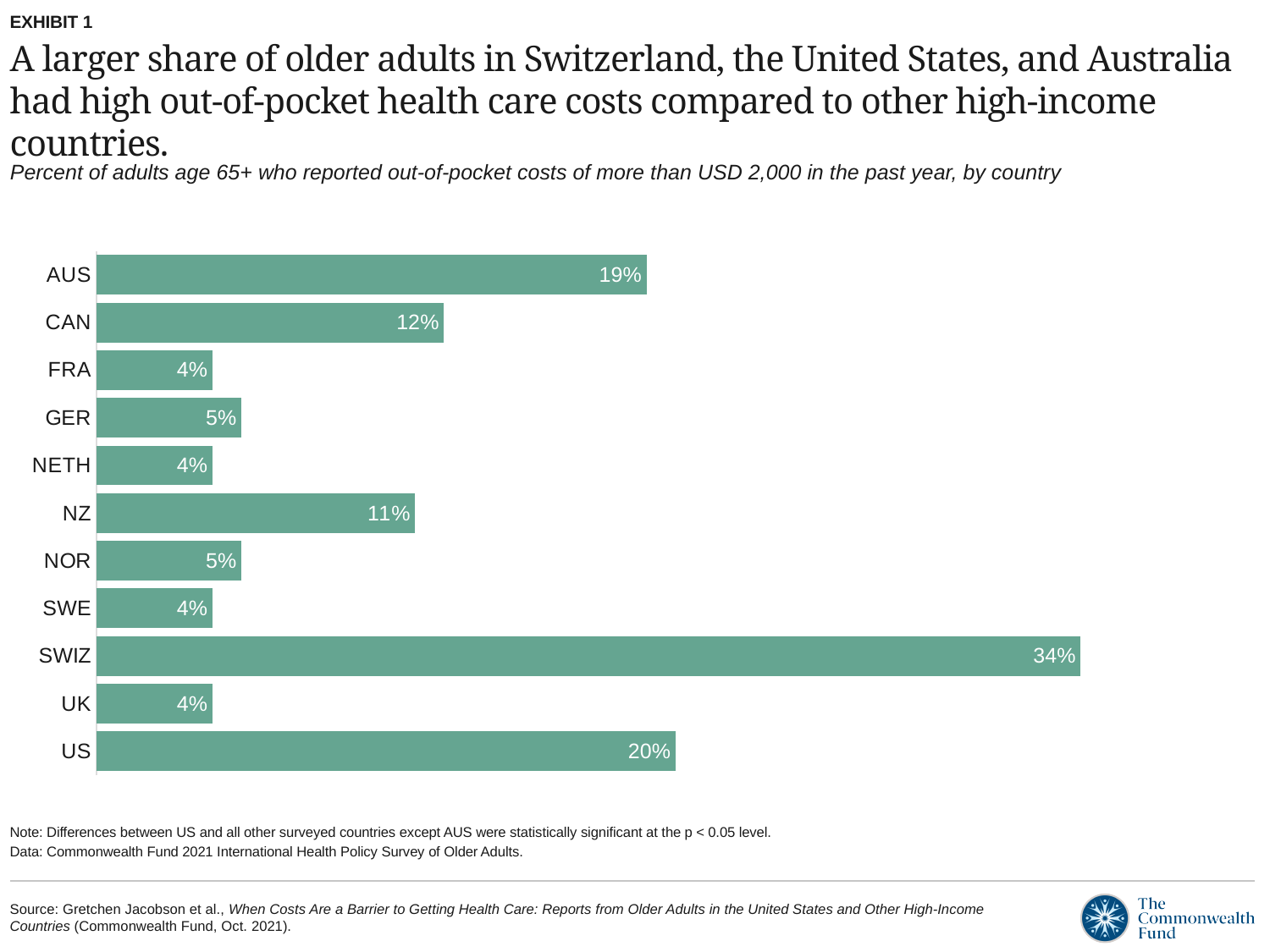
What is the value shown for NZ? 11% What percent of adults age 65+ in SWIZ reported out-of-pocket costs of more than USD 2,000? 34% How many countries have a value of 4%? 4 How many countries are shown in the chart? 11 Which is larger, the value for CAN or the value for NZ? CAN What is the difference in percentage points between SWIZ and the US? 14 What is the value shown for CAN? 12% What is the difference in percentage points between AUS and CAN? 7 What kind of chart is shown on the slide? Bar chart Which is larger, the value for the US or the value for AUS? US What is the value shown for the US? 20% Which country has the highest share of older adults with out-of-pocket costs over USD 2,000? SWIZ